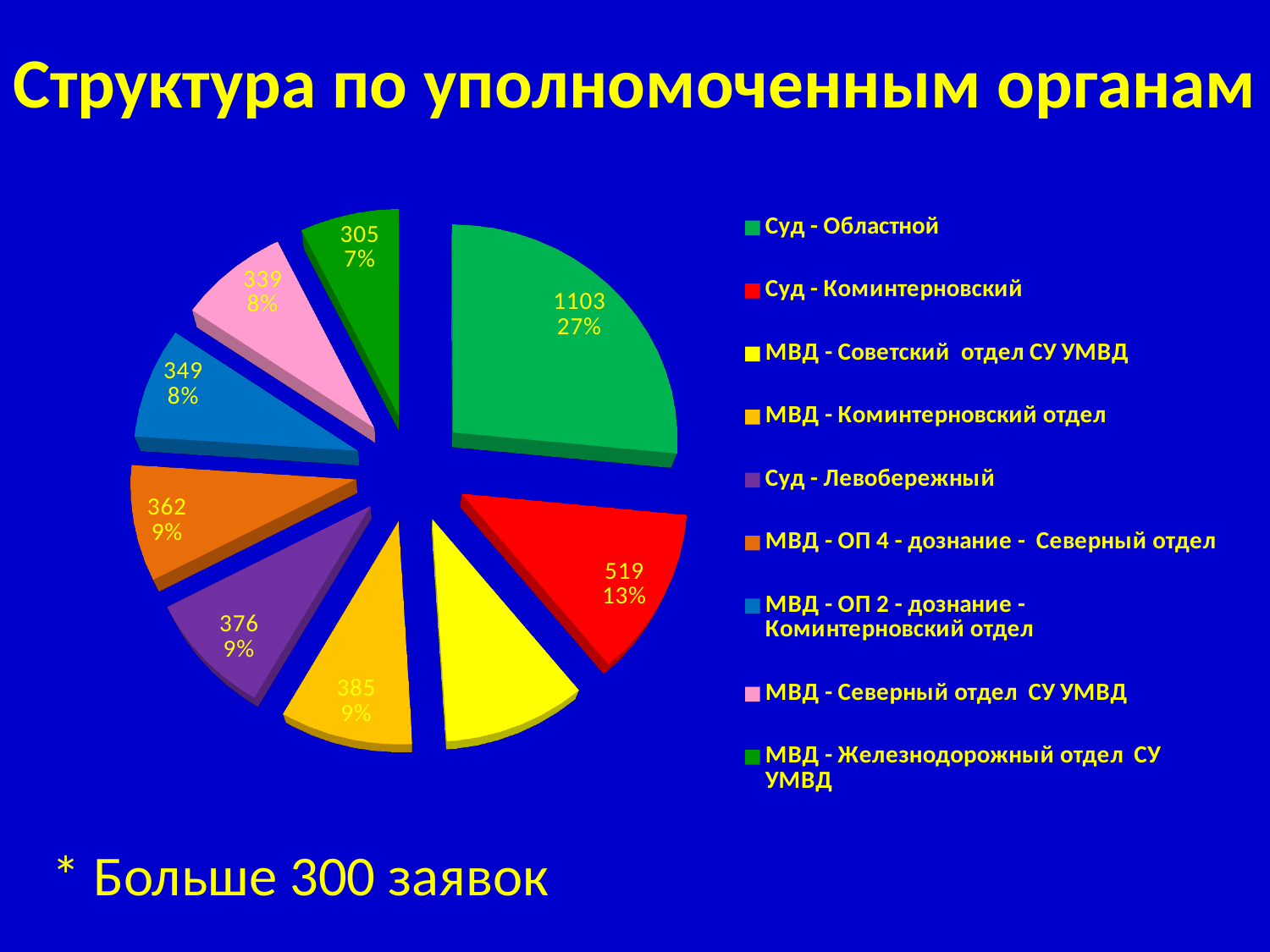
What is the difference between the values for Суд - Областной and Суд - Коминтерновский? 584 What share of the pie does МВД - ОП 2 - дознание - Коминтерновский отдел represent? 8% Which category has the smallest slice of the pie? МВД - Железнодорожный отдел СУ УМВД Which is larger: Суд - Левобережный or МВД - ОП 4 - дознание - Северный отдел? Суд - Левобережный Which category has the largest slice of the pie? Суд - Областной What is the value for МВД - Северный отдел СУ УМВД? 339 How many categories does the pie chart's legend list? 9 What share of the pie does Суд - Областной represent? 27% What kind of chart is shown on the slide? pie chart What is the title of the slide? Структура по уполномоченным органам What is the value for Суд - Коминтерновский? 519 What is the value for Суд - Областной? 1103